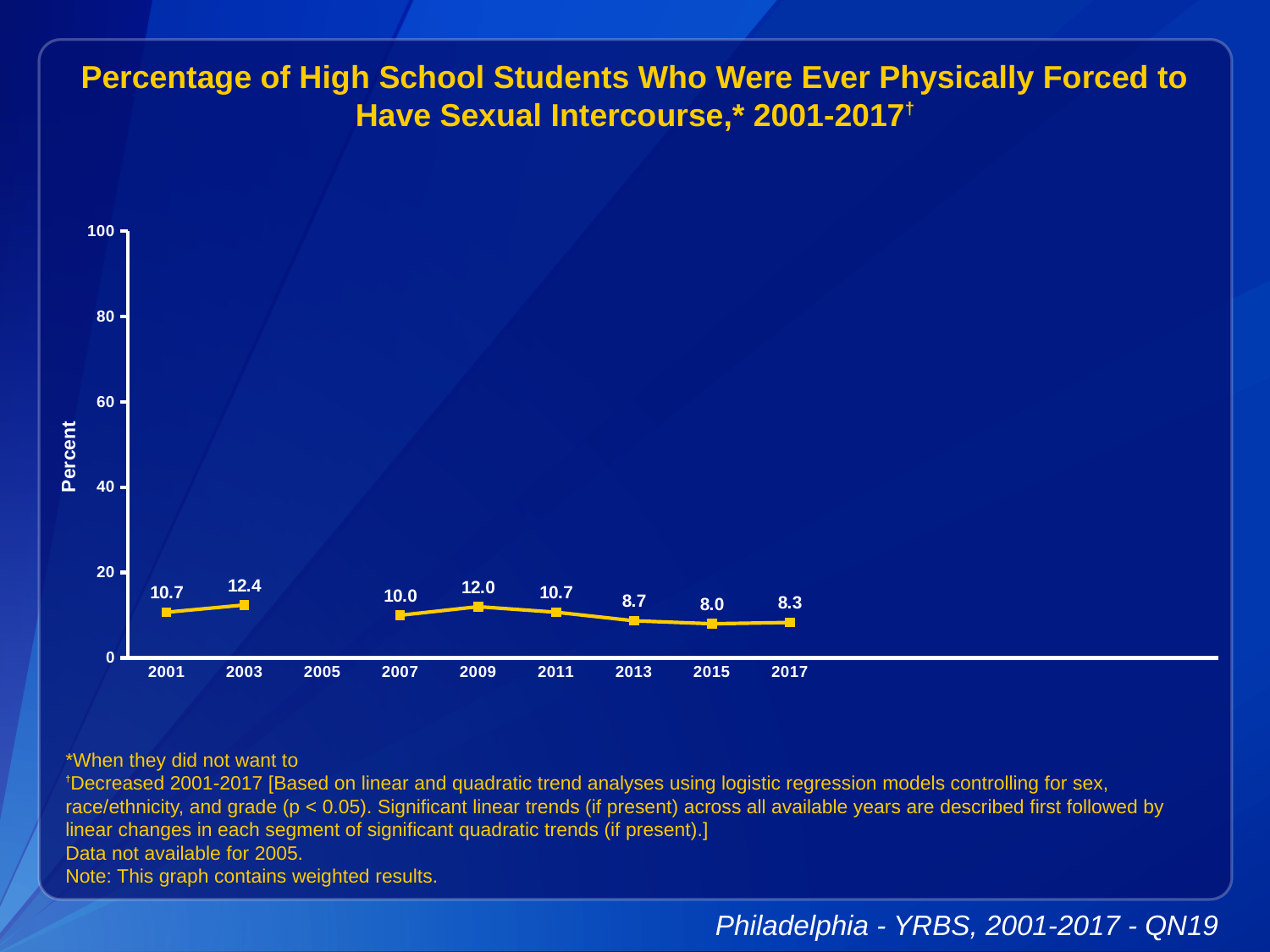
Is the value for 2009 greater or less than 20? less Do the values generally rise or fall from 2009 to 2015? fall What is the value for 2009? 12.0 What is the value for 2001? 10.7 What is the difference between the values for 2003 and 2017? 4.1 How many years have a plotted data point? 8 Which year has the highest value? 2003 What is the value for 2017? 8.3 What kind of chart is this? line chart Which year has the lowest value? 2015 What is the label on the y axis? Percent Which is larger, the value for 2007 or the value for 2011? 2011